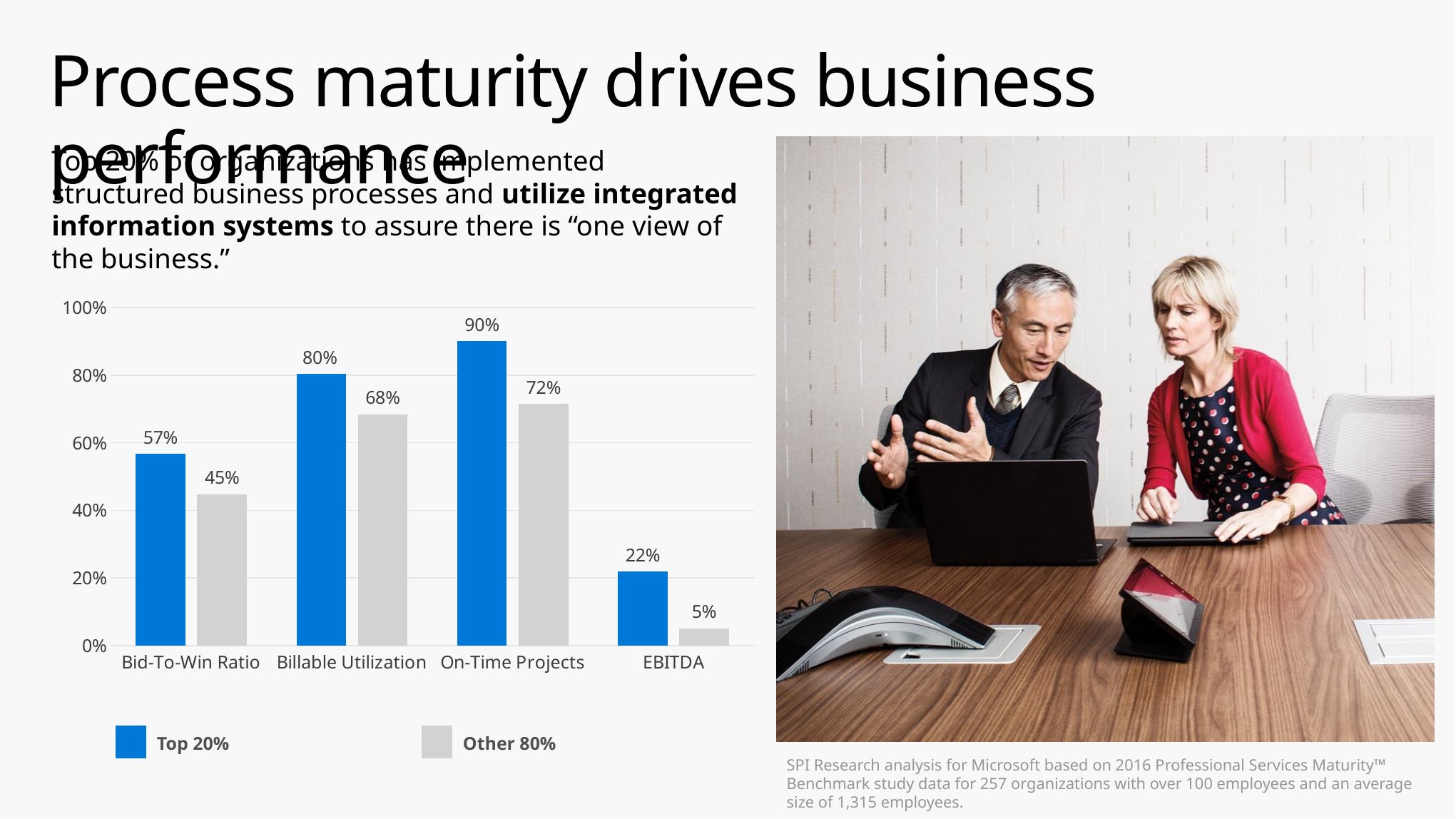
What is the Other 80% value for Billable Utilization? 68% What is the Top 20% value for Bid-To-Win Ratio? 57% What kind of chart is shown on the slide? Bar chart Which category has the lowest Other 80% value? EBITDA Which category has the highest Top 20% value? On-Time Projects What is the difference between the Top 20% and Other 80% values for Billable Utilization? 12% How many categories are shown on the x axis? 4 How many series does the legend list? 2 What is the Top 20% value for On-Time Projects? 90% What is the Other 80% value for EBITDA? 5% What colour are the Top 20% bars? Blue Which is larger for EBITDA: the Top 20% value or the Other 80% value? Top 20%